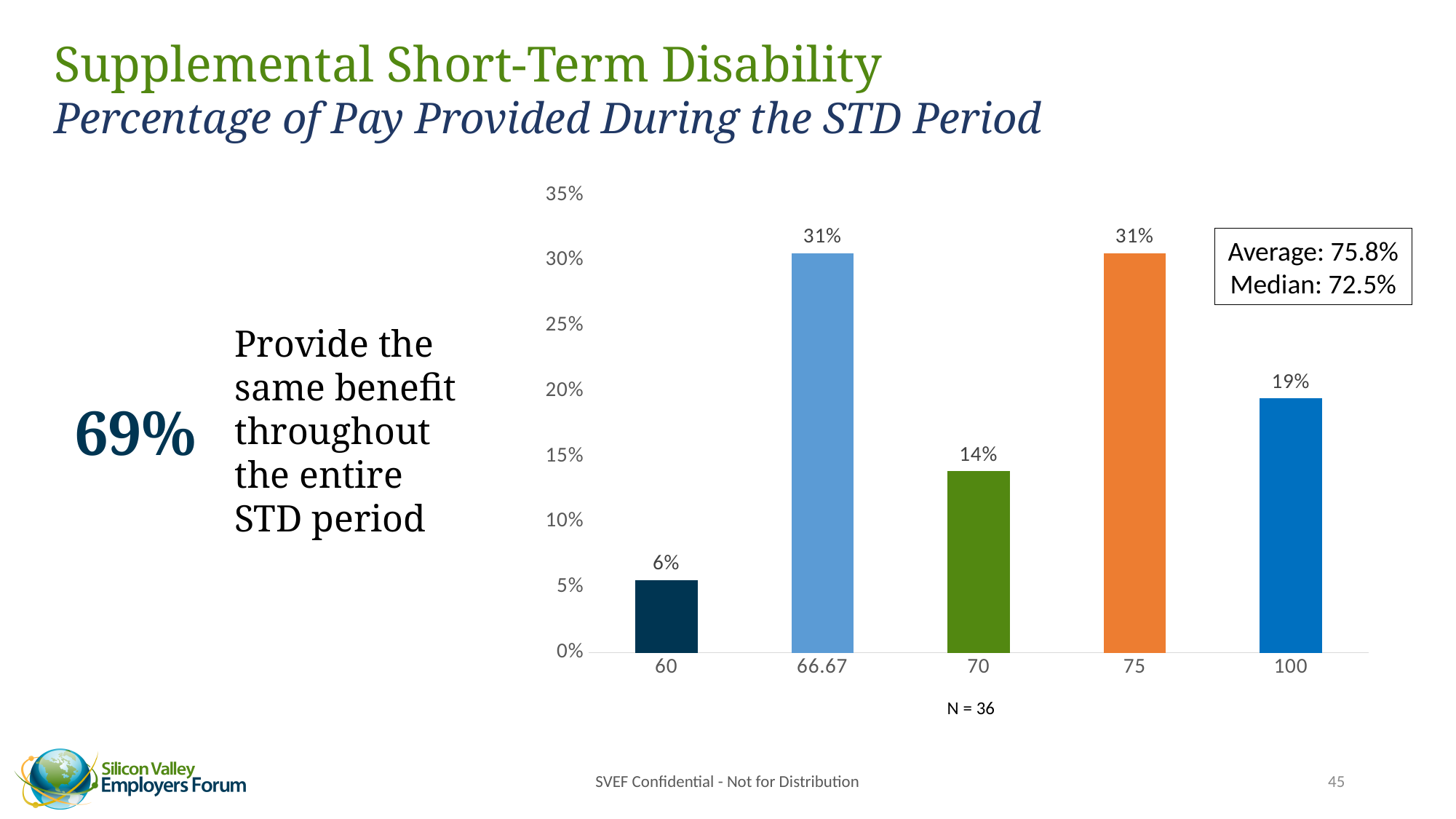
Which category has the lowest value? 60 Which is larger, the value for 70 or the value for 100? 100 What is the value shown for the 70 category? 14% What sample size (N) is shown below the chart? N = 36 What kind of chart is shown on the slide? bar chart What is the difference between the values for 70 and 60? 8% What is the value shown for the 100 category? 19% How many categories are shown on the x axis? 5 What percentage of companies provide 66.67 percent of pay during the STD period? 31% What is the average percentage of pay stated in the box on the chart? 75.8% What is the difference between the values for 75 and 100? 12% Is the value for 66.67 greater or less than 25%? greater